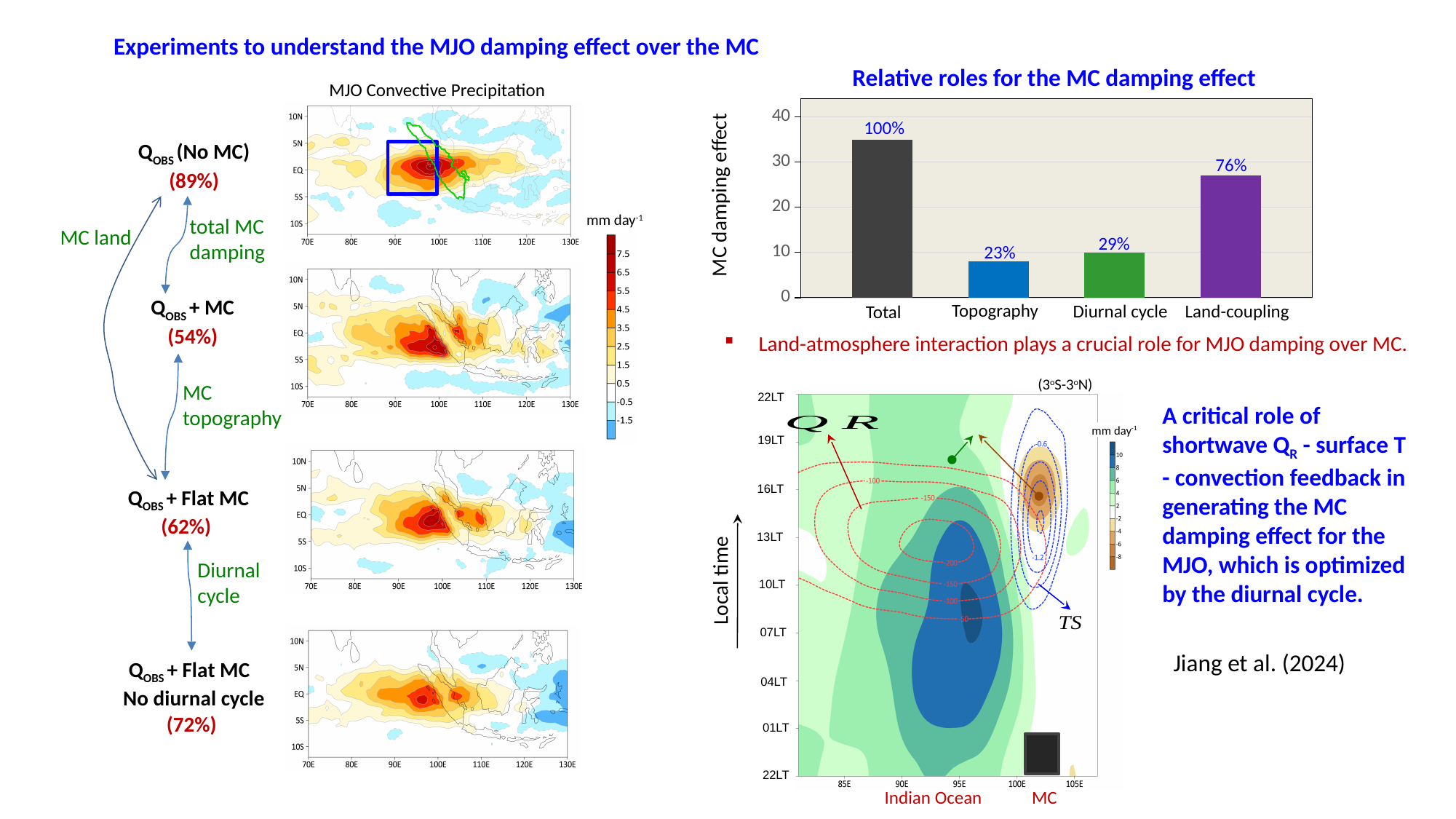
In the bar chart 'Relative roles for the MC damping effect', which category has the highest bar? Total In the bar chart 'Relative roles for the MC damping effect', which is larger, Land-coupling or Diurnal cycle? Land-coupling In the bar chart 'Relative roles for the MC damping effect', which category has the lowest bar? Topography What kind of chart is 'Relative roles for the MC damping effect'? bar chart In the bar chart 'Relative roles for the MC damping effect', what is the difference between the percentage labels for Diurnal cycle and Topography? 6% In the bar chart 'Relative roles for the MC damping effect', what percentage label is shown on the Diurnal cycle bar? 29% In the bar chart 'Relative roles for the MC damping effect', what percentage label is shown on the Topography bar? 23% How many categories are shown in the bar chart 'Relative roles for the MC damping effect'? 4 What is the y-axis label of the bar chart 'Relative roles for the MC damping effect'? MC damping effect In the bar chart 'Relative roles for the MC damping effect', is the value for Total greater or less than 30? greater In the bar chart 'Relative roles for the MC damping effect', is the value for Land-coupling greater or less than 20? greater In the bar chart 'Relative roles for the MC damping effect', what percentage label is shown on the Land-coupling bar? 76%